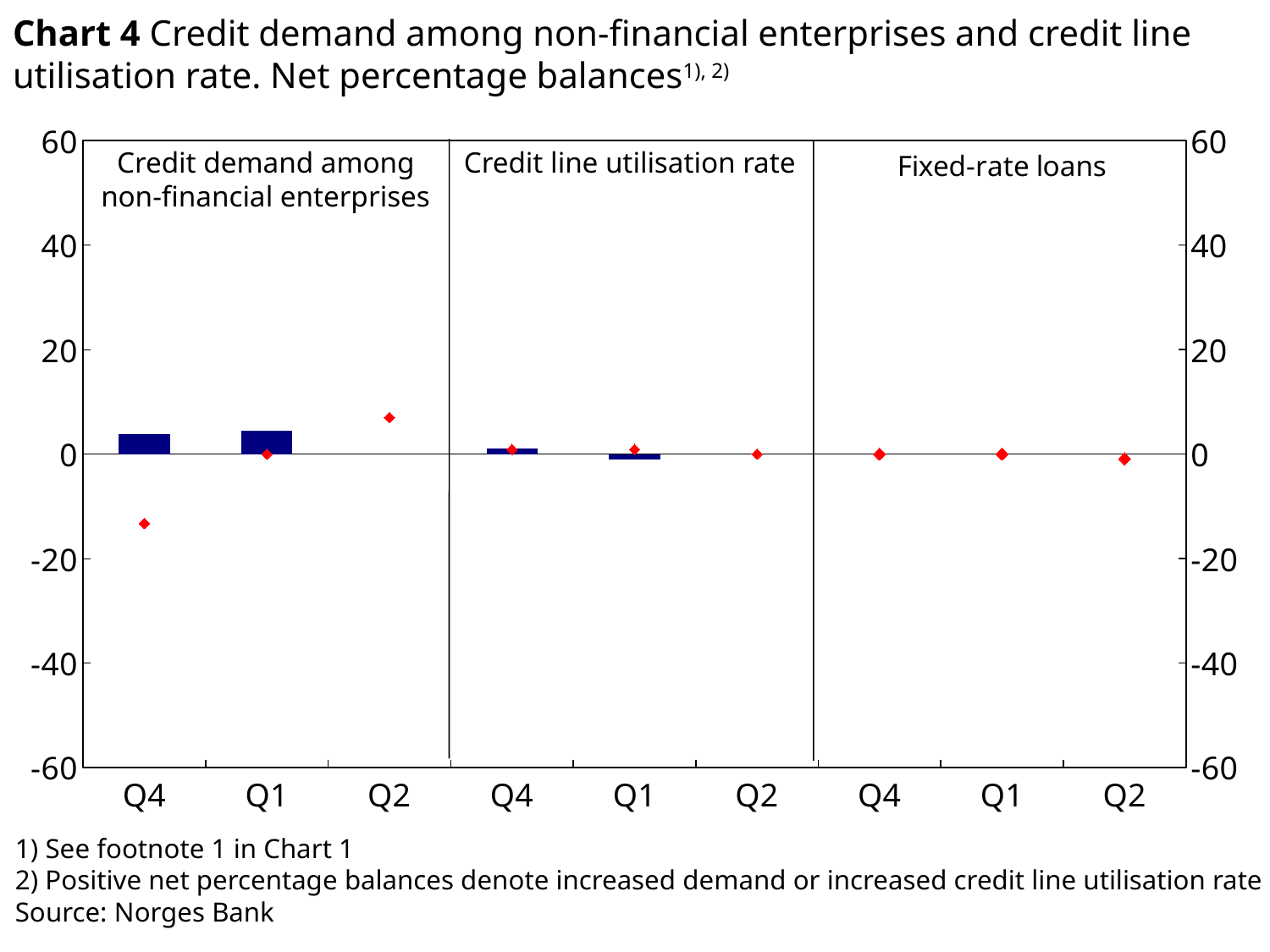
In the 'Credit demand among non-financial enterprises' panel, is the red diamond marker for Q2 greater or less than 0? greater In the 'Credit demand among non-financial enterprises' panel, is the red diamond marker for Q4 greater or less than -20? greater How many panels (sections) does the chart have? 3 What is the maximum value shown on the vertical axis? 60 In the 'Credit demand among non-financial enterprises' panel, is the red diamond marker for Q4 greater or less than 0? less What is the title of the third panel of the chart? Fixed-rate loans How many categories are shown on the x axis in total across all panels? 9 What kind of chart is shown on the slide? combination bar and line chart (bars with diamond markers) In the 'Credit demand among non-financial enterprises' panel, which quarter has the lowest red diamond marker? Q4 How many quarters are shown on the x axis within the 'Credit demand among non-financial enterprises' panel? 3